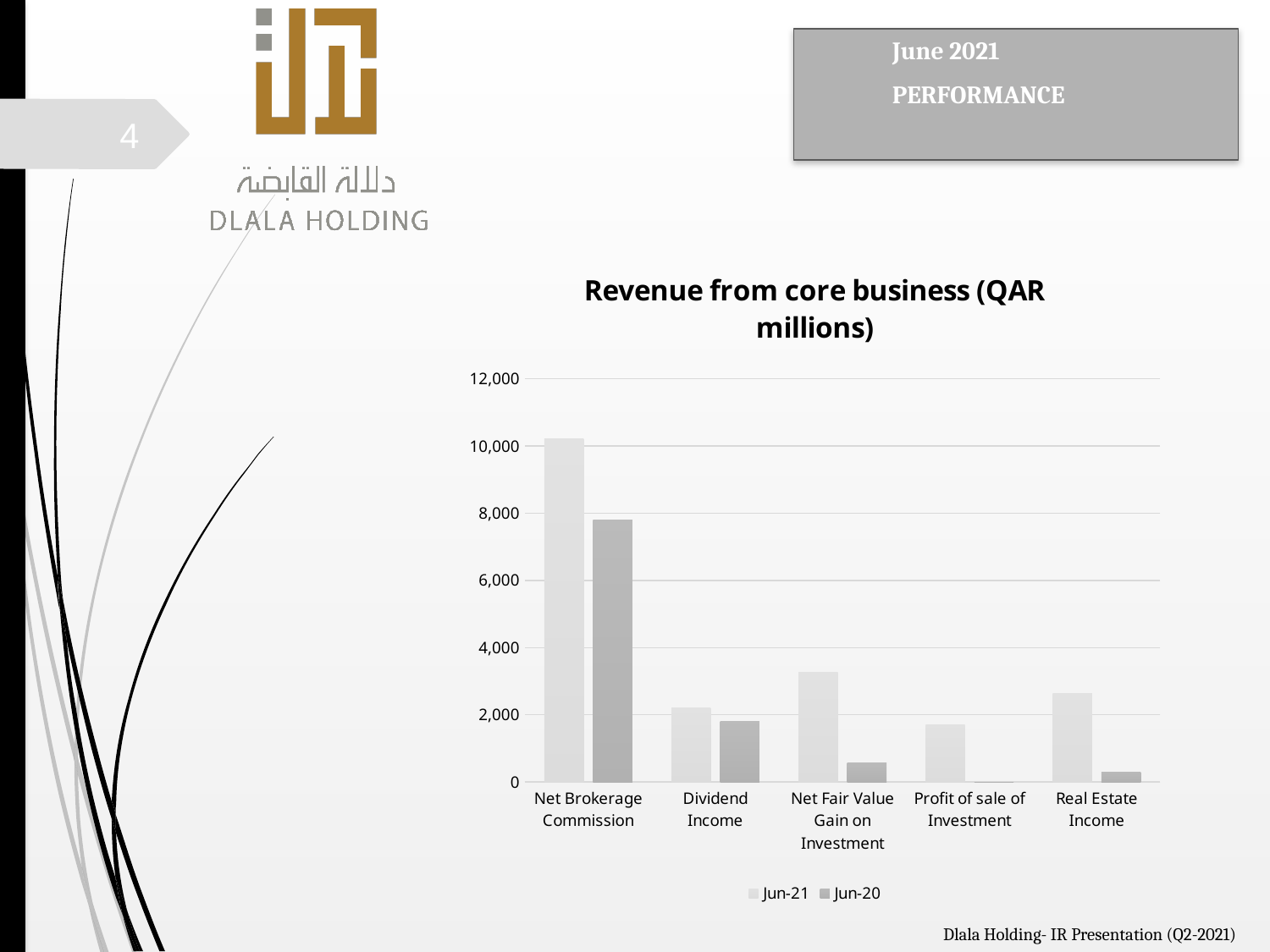
Is the Jun-21 value for Net Fair Value Gain on Investment greater or less than 2,000? greater Is the Jun-20 value for Net Brokerage Commission greater or less than 6,000? greater For Real Estate Income, which is larger: the Jun-21 value or the Jun-20 value? Jun-21 Which category has the lowest Jun-21 value? Profit of sale of Investment What is the title of the chart? Revenue from core business (QAR millions) Is the Jun-21 value for Net Brokerage Commission greater or less than 8,000? greater How many series does the legend list? 2 For Dividend Income, which is larger: the Jun-21 value or the Jun-20 value? Jun-21 Which category has the highest Jun-21 value? Net Brokerage Commission Which category has the lowest Jun-20 value? Profit of sale of Investment How many revenue categories are shown on the x axis? 5 What kind of chart is shown on the slide? Bar chart